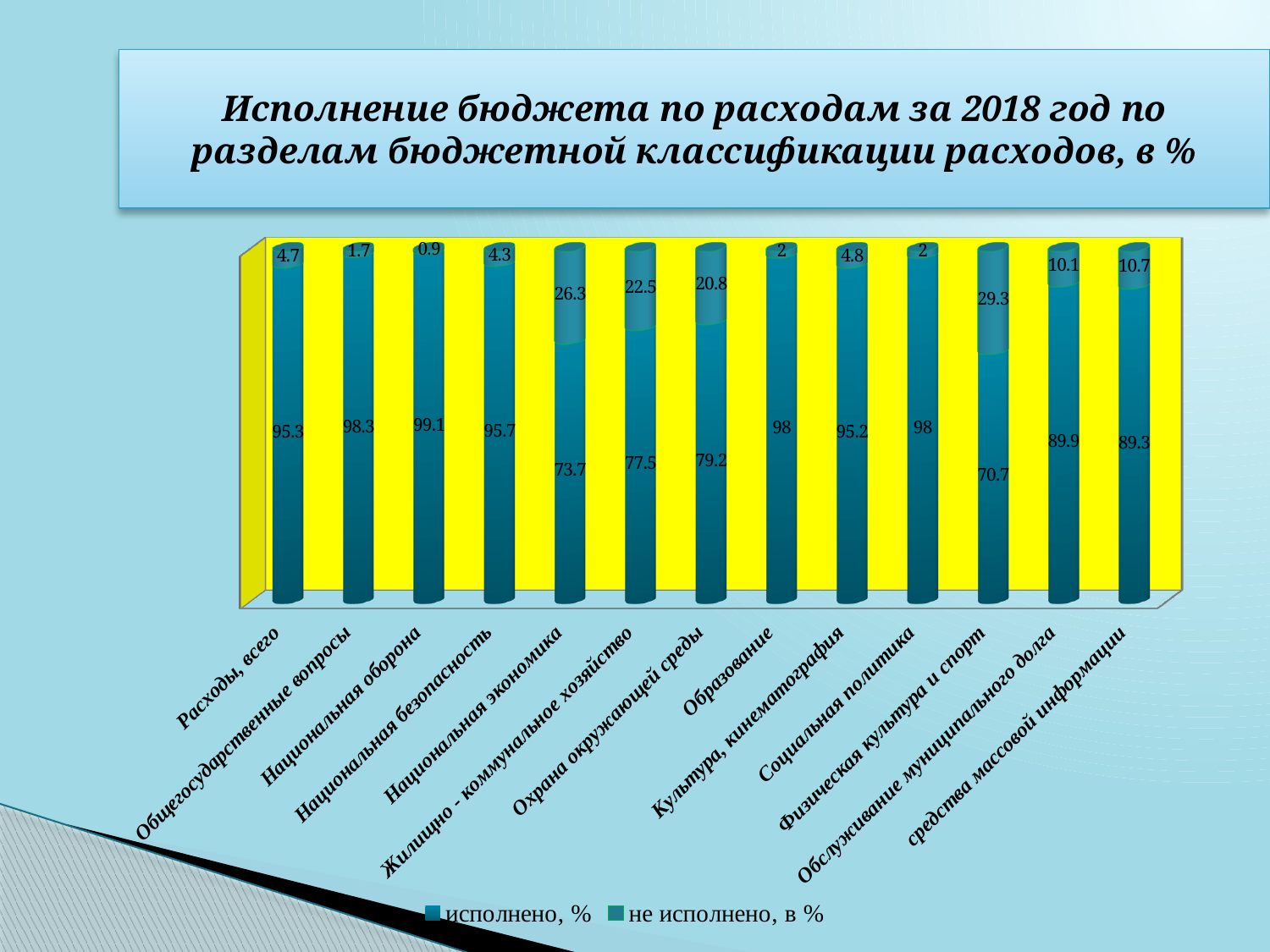
Which category has the highest value of "исполнено, %"? Национальная оборона What is the value of "исполнено, %" for Жилищно - коммунальное хозяйство? 77.5 How many series does the legend list? 2 What is the value of "не исполнено, в %" for Физическая культура и спорт? 29.3 Which category has the lowest value of "не исполнено, в %"? Национальная оборона Which category has the lowest value of "исполнено, %"? Физическая культура и спорт What is the value of "исполнено, %" for Национальная оборона? 99.1 What is the total of the stacked bar for Обслуживание муниципального долга? 100 What is the difference between the "исполнено, %" values for Общегосударственные вопросы and Национальная экономика? 24.6 How many categories are shown on the x axis? 13 What kind of chart is shown on the slide? Stacked bar chart Which has a larger "не исполнено, в %" value: Национальная экономика or Охрана окружающей среды? Национальная экономика